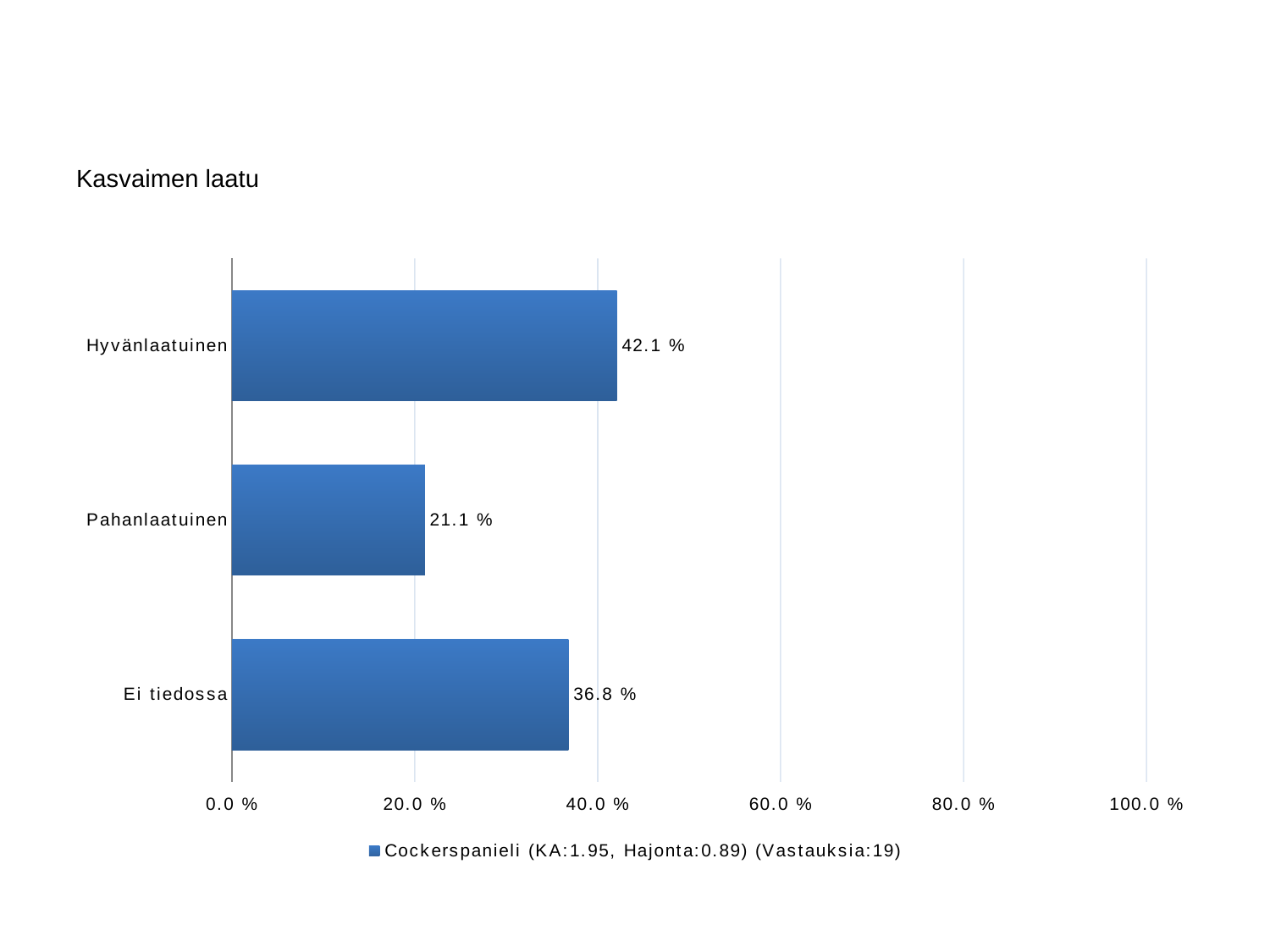
Which is larger, the value for Ei tiedossa or the value for Pahanlaatuinen? Ei tiedossa What is the difference between the values for Hyvänlaatuinen and Pahanlaatuinen? 21.0 % How many categories are shown in the chart? 3 What is the difference between the values for Hyvänlaatuinen and Ei tiedossa? 5.3 % Which category has the lowest value? Pahanlaatuinen Is the value for Ei tiedossa greater or less than 40.0 %? less What is the value for Ei tiedossa? 36.8 % What kind of chart is shown on the slide? bar chart What is the title of the chart? Kasvaimen laatu Which category has the highest value? Hyvänlaatuinen What is the value for Hyvänlaatuinen? 42.1 % What is the value for Pahanlaatuinen? 21.1 %